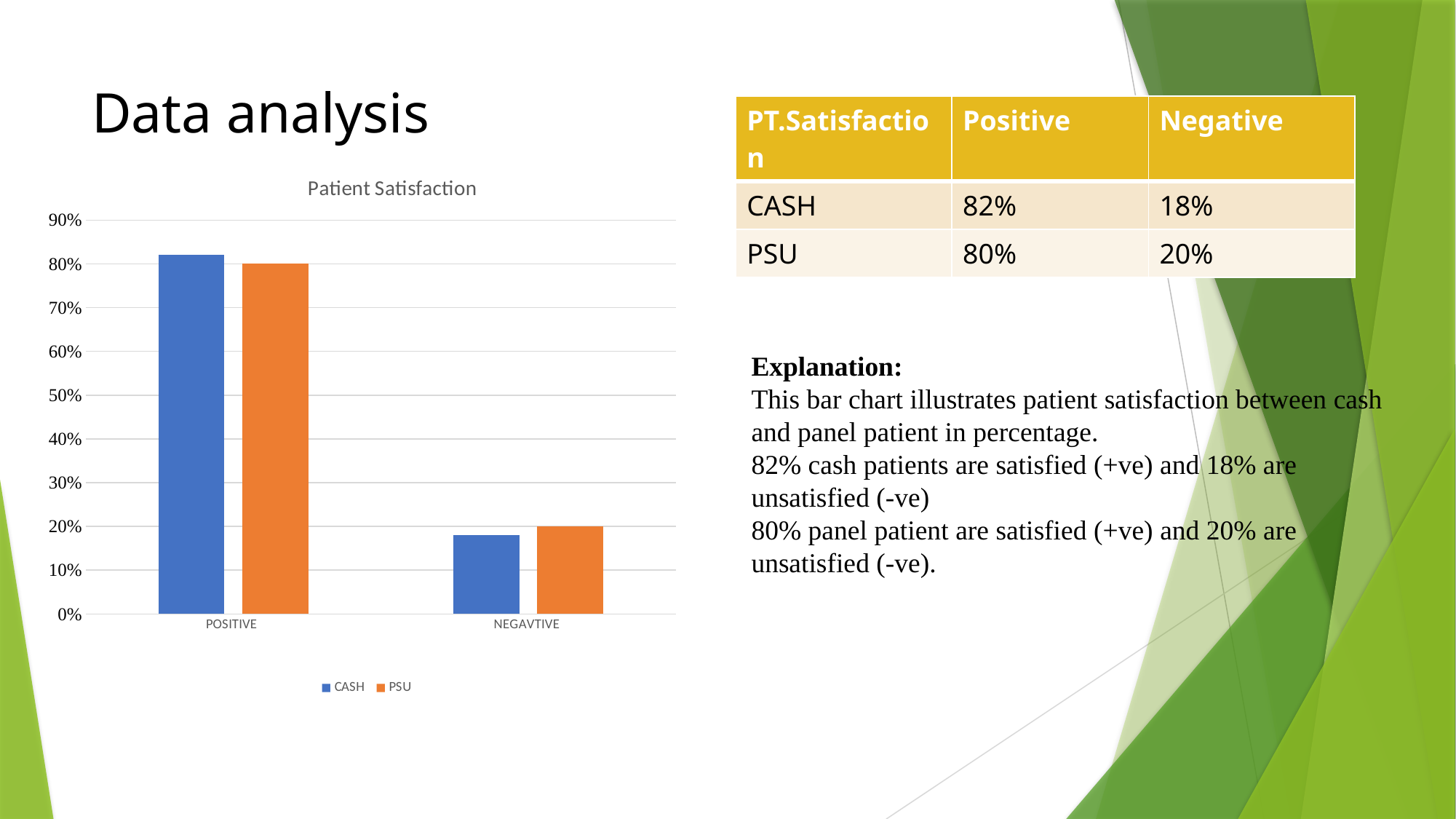
What is the value for PSU in the POSITIVE category? 80% Is the value for CASH in the POSITIVE category greater or less than 50%? greater How many categories are shown on the x axis of the chart? 2 How many series does the chart legend list? 2 What is the value for PSU in the NEGAVTIVE category? 20% Which category has the lowest value for the PSU series? NEGAVTIVE Which category has the highest value for the CASH series? POSITIVE What is the title of the chart? Patient Satisfaction What type of chart is shown on the slide? bar chart What is the value for CASH in the NEGAVTIVE category? 18% What is the difference between the CASH and PSU values in the POSITIVE category? 2% What is the value for CASH in the POSITIVE category? 82%